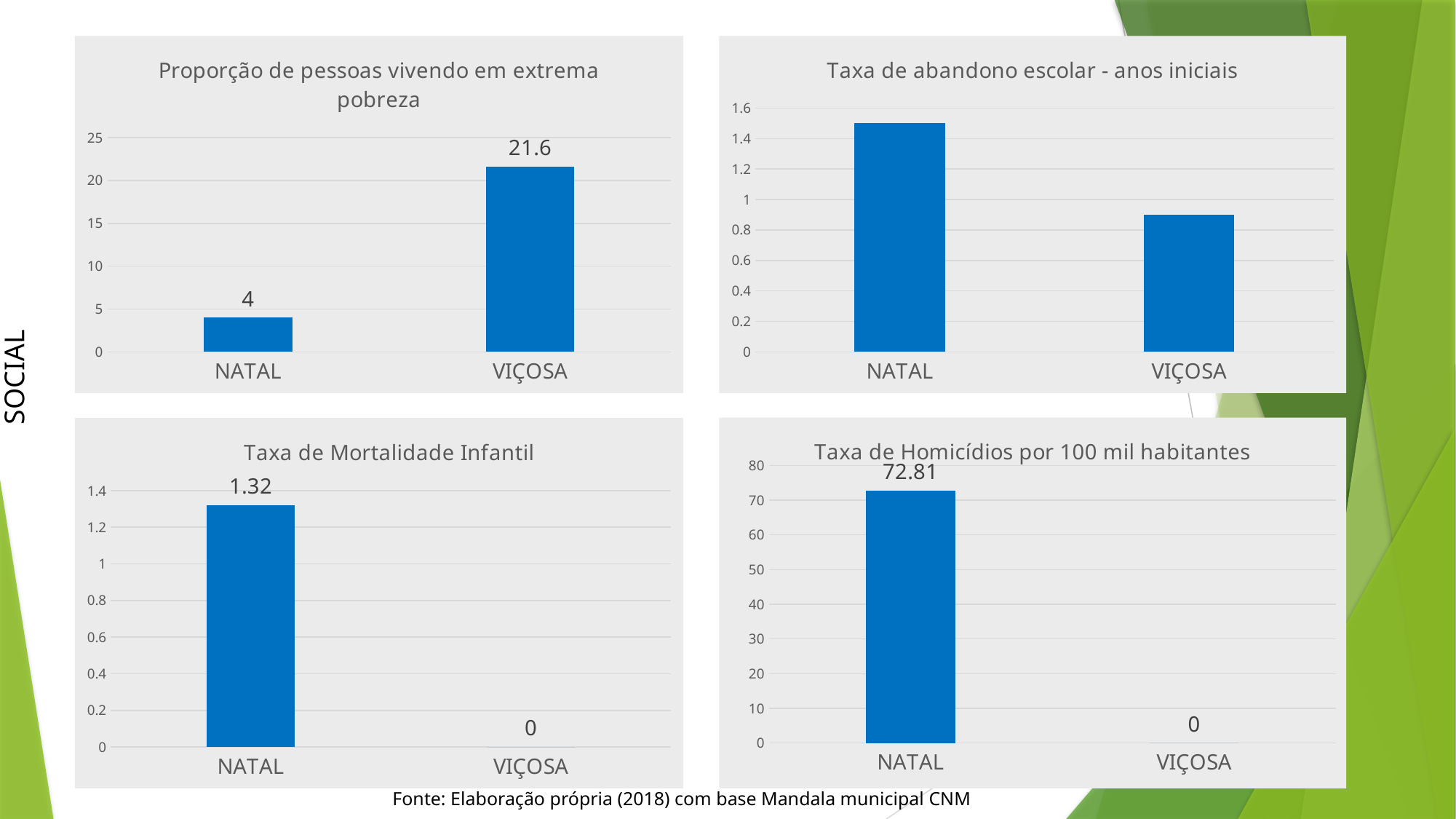
In the chart 'Taxa de abandono escolar - anos iniciais', which category has the highest value? NATAL In the chart 'Proporção de pessoas vivendo em extrema pobreza', what is the value for VIÇOSA? 21.6 In the chart 'Taxa de abandono escolar - anos iniciais', is the value for VIÇOSA greater or less than 1? less In the chart 'Taxa de abandono escolar - anos iniciais', is the value for NATAL greater or less than 1.2? greater In the chart 'Taxa de Mortalidade Infantil', what is the value for NATAL? 1.32 How many charts are shown on the slide? 4 In the chart 'Proporção de pessoas vivendo em extrema pobreza', what is the value for NATAL? 4 In the chart 'Taxa de Mortalidade Infantil', what is the value for VIÇOSA? 0 In the chart 'Proporção de pessoas vivendo em extrema pobreza', what is the difference between the values for VIÇOSA and NATAL? 17.6 What kind of chart is 'Taxa de Homicídios por 100 mil habitantes'? bar chart In the chart 'Taxa de Homicídios por 100 mil habitantes', which category has the lowest value? VIÇOSA In the chart 'Taxa de Homicídios por 100 mil habitantes', what is the value for NATAL? 72.81